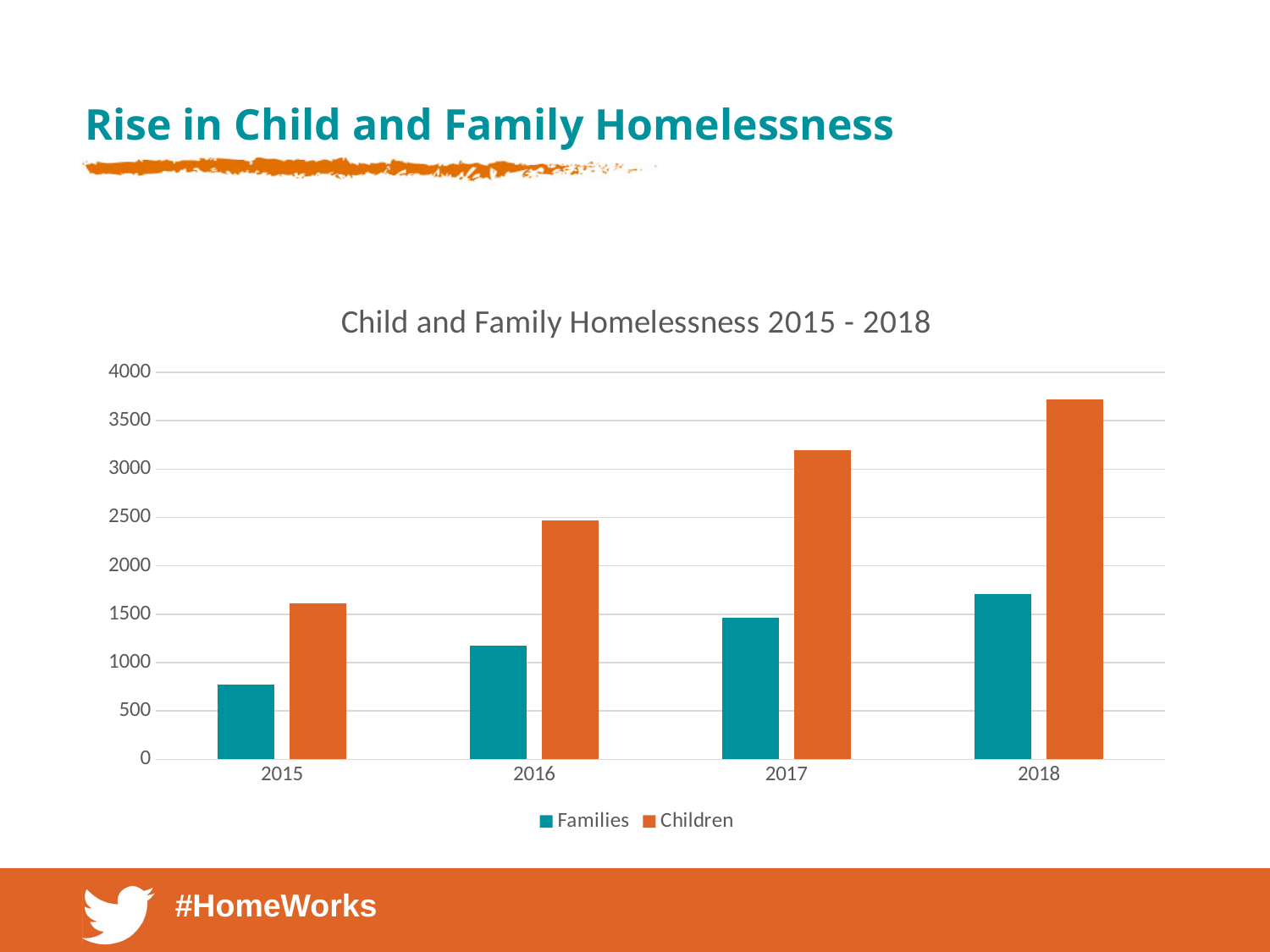
How many years are shown on the x axis? 4 Is the value for Children in 2017 greater or less than 3000? greater Which colour represents the Children series? orange Is the value for Children in 2018 greater or less than 3500? greater Which is larger in 2016, the value for Families or the value for Children? Children What is the title of the chart? Child and Family Homelessness 2015 - 2018 Which year has the lowest value for Families? 2015 Do the values for Families rise or fall from 2015 to 2018? rise Is the value for Families in 2015 greater or less than 1000? less How many series does the legend list? 2 Which year has the highest value for Children? 2018 What type of chart is shown on the slide? bar chart